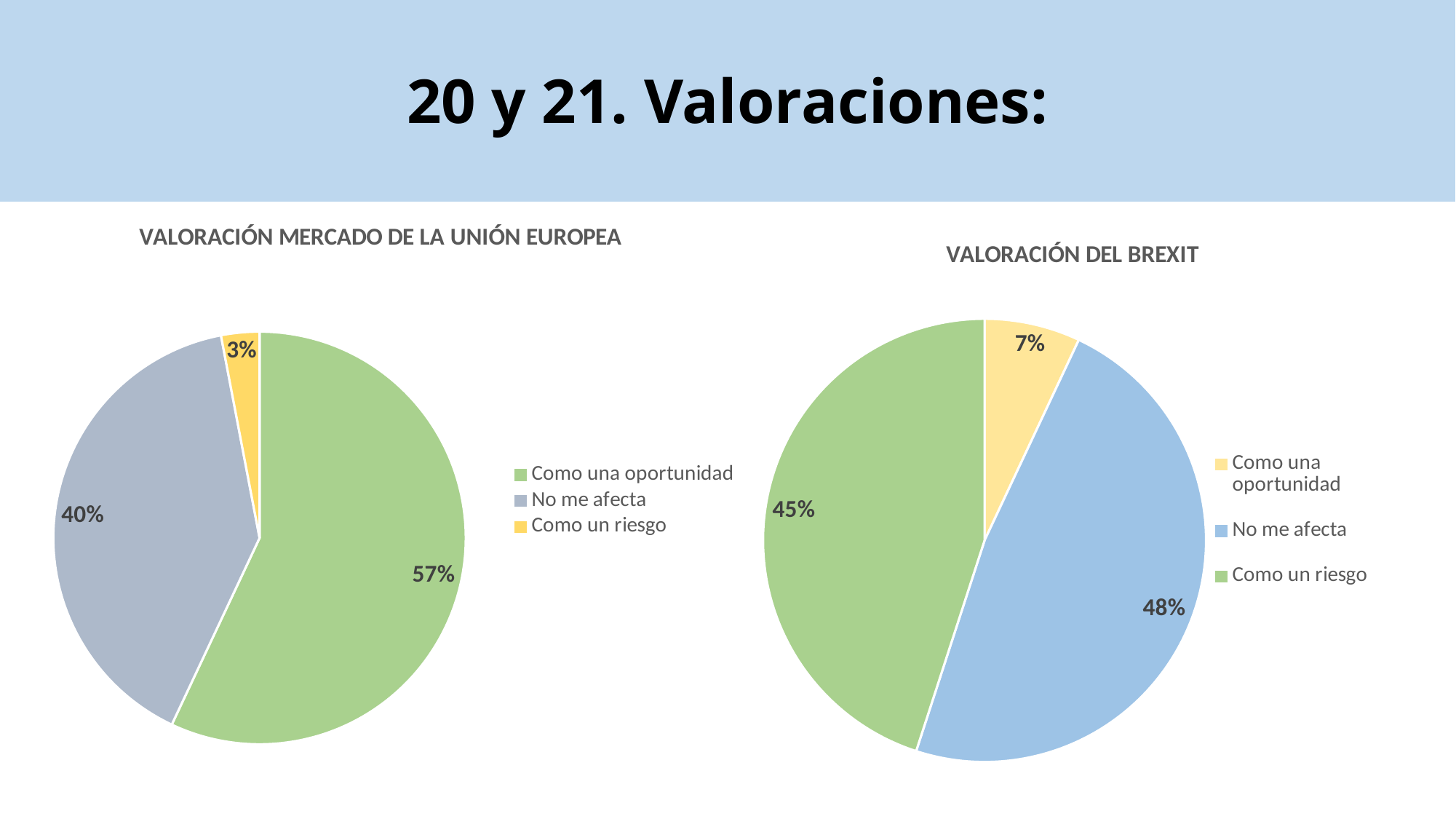
What type of chart is used for 'VALORACIÓN DEL BREXIT'? Pie chart How many categories does the legend of the 'VALORACIÓN MERCADO DE LA UNIÓN EUROPEA' chart list? 3 In the 'VALORACIÓN DEL BREXIT' chart, which category has the largest slice? No me afecta In the 'VALORACIÓN MERCADO DE LA UNIÓN EUROPEA' chart, which category has the smallest slice? Como un riesgo In the 'VALORACIÓN MERCADO DE LA UNIÓN EUROPEA' chart, what share is labelled for 'No me afecta'? 40% In the 'VALORACIÓN MERCADO DE LA UNIÓN EUROPEA' chart, what share is labelled for 'Como una oportunidad'? 57% In the 'VALORACIÓN DEL BREXIT' chart, what colour is the 'Como un riesgo' slice? Green In the 'VALORACIÓN DEL BREXIT' chart, which is larger: 'No me afecta' or 'Como un riesgo'? No me afecta In the 'VALORACIÓN DEL BREXIT' chart, what is the difference between the 'Como un riesgo' and 'Como una oportunidad' shares? 38 percentage points In the 'VALORACIÓN DEL BREXIT' chart, what share is labelled for 'Como una oportunidad'? 7% In the 'VALORACIÓN MERCADO DE LA UNIÓN EUROPEA' chart, what is the difference between the 'Como una oportunidad' and 'No me afecta' shares? 17 percentage points In the 'VALORACIÓN DEL BREXIT' chart, what share is labelled for 'No me afecta'? 48%